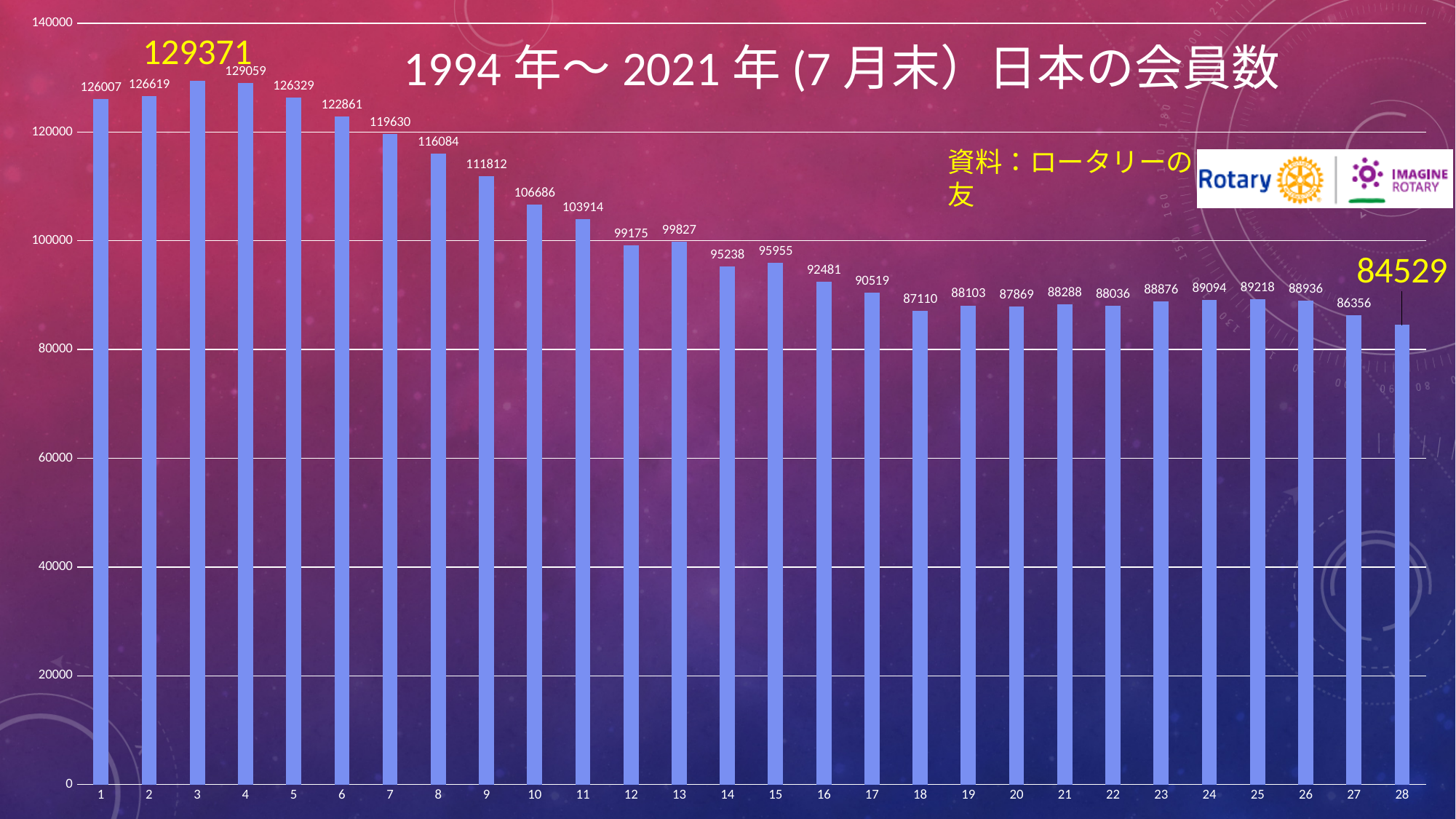
What is the title of the chart? 1994年～2021年(7月末) 日本の会員数 What is the difference between the values for category 3 and category 28? 44842 What is the value for category 28? 84529 Is the value for category 18 greater or less than 100000? less What is the value for category 10? 106686 How many bars (categories) are plotted in the chart? 28 What type of chart is shown on the slide? bar chart Do the values generally rise or fall from category 1 to category 28? fall Which category has the highest value? 3 What is the value for category 3? 129371 Which category has the lowest value? 28 Which is larger, the value for category 12 or category 13? category 13